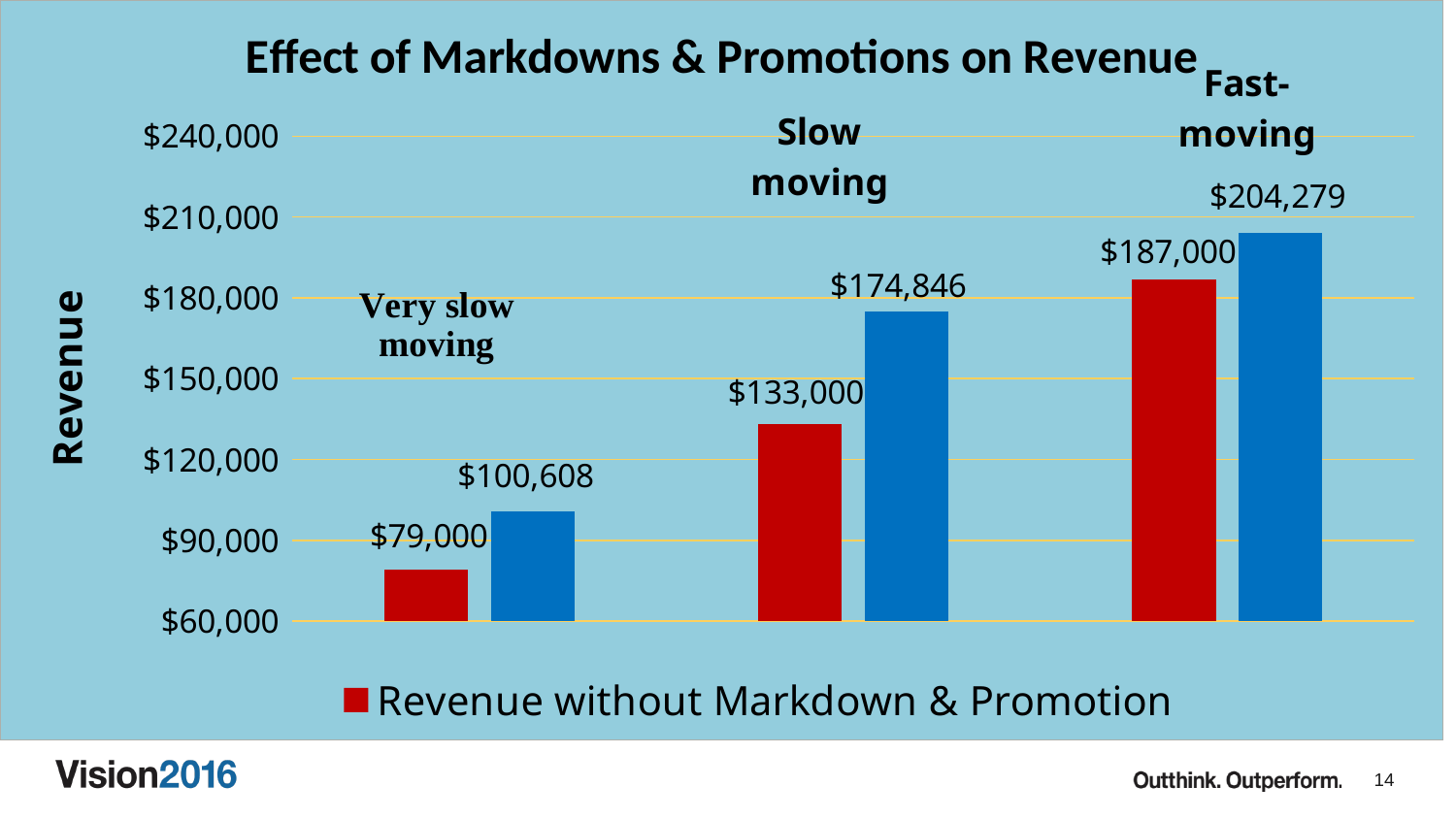
Which is larger: the Revenue without Markdown & Promotion for Slow moving or the blue bar for Very slow moving? Slow moving Revenue without Markdown & Promotion What is the difference between the blue bar and the red bar for the Fast-moving category? $17,279 What is the Revenue without Markdown & Promotion for the Slow moving category? $133,000 What kind of chart is shown on the slide? Bar chart Which category has the highest Revenue without Markdown & Promotion? Fast-moving What is the Revenue without Markdown & Promotion for the Fast-moving category? $187,000 What is the difference between the blue bar and the red bar for the Slow moving category? $41,846 Which category has the lowest Revenue without Markdown & Promotion? Very slow moving What value is labelled on the blue bar for the Very slow moving category? $100,608 What value is labelled on the blue bar for the Fast-moving category? $204,279 How many categories are shown on the chart? 3 What is the Revenue without Markdown & Promotion for the Very slow moving category? $79,000